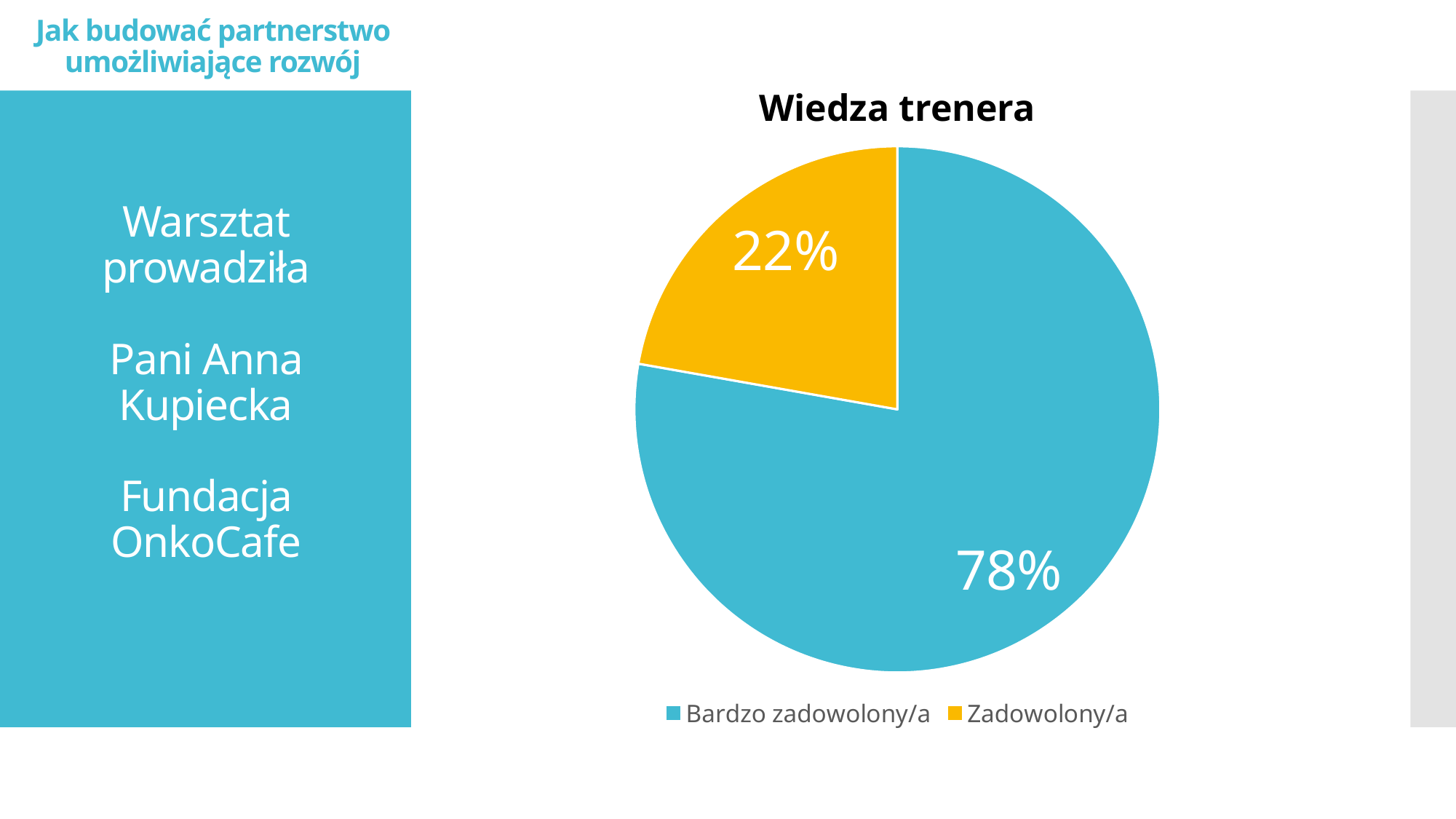
What type of chart is shown on the slide? pie chart How many entries does the legend list? 2 What is the difference in percentage points between the "Bardzo zadowolony/a" and "Zadowolony/a" slices? 56 Which is larger: the "Bardzo zadowolony/a" slice or the "Zadowolony/a" slice? Bardzo zadowolony/a What colour is the "Zadowolony/a" slice? yellow What is the title of the chart? Wiedza trenera What share of the pie is labelled "Zadowolony/a"? 22% How many slices does the pie chart have? 2 Which category has the smallest slice of the pie? Zadowolony/a What is the total of the two slice percentages shown? 100% Which category has the largest slice of the pie? Bardzo zadowolony/a What share of the pie is labelled "Bardzo zadowolony/a"? 78%